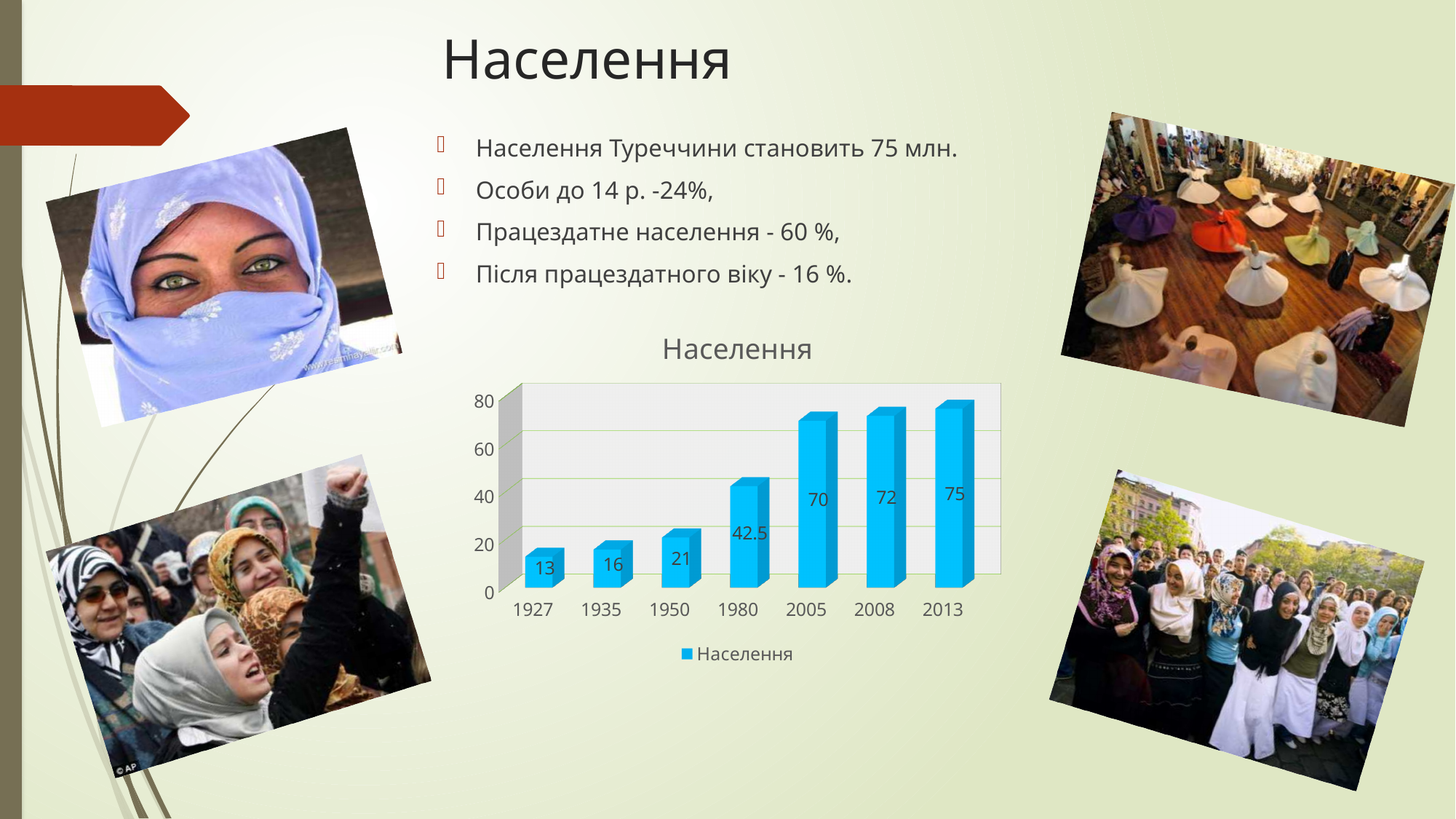
Which year has the lowest value in the chart? 1927 Which is larger, the value for 1950 or the value for 1935? 1950 Which year has the highest value in the chart? 2013 What is the value for 2008 in the chart? 72 How many years are shown on the x axis of the chart? 7 What kind of chart is shown on the slide? bar chart Do the values rise or fall from 1927 to 2013? rise What is the difference between the values for 2013 and 1927? 62 Is the value for 2005 greater or less than 60? greater What is the difference between the values for 2005 and 1980? 27.5 What is the value for 1927 in the chart? 13 What is the value for 1980 in the chart? 42.5